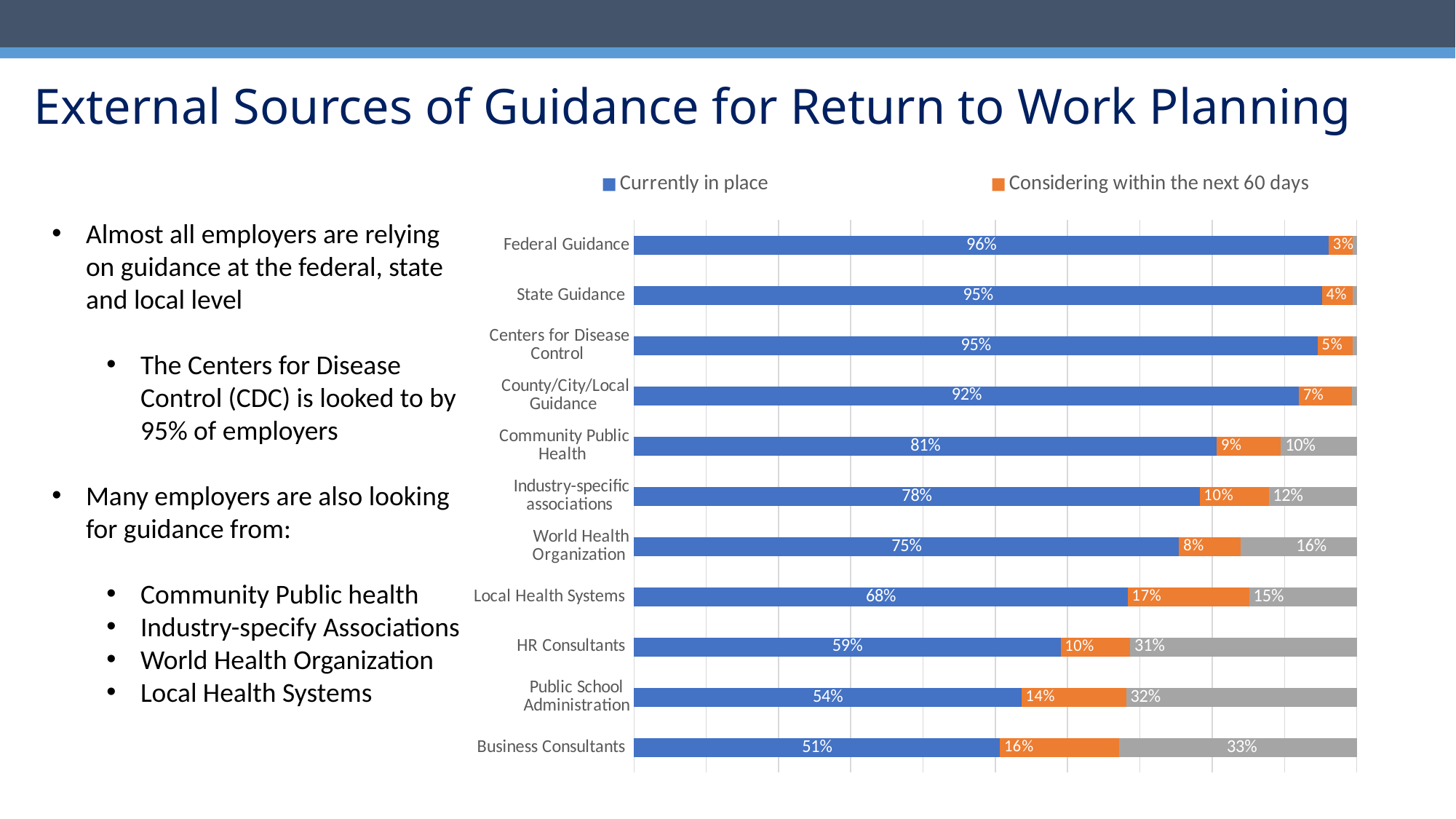
What is the difference between the 'Currently in place' values for Federal Guidance and Business Consultants? 45% What colour represents the 'Considering within the next 60 days' series? Orange What is the 'Currently in place' value for Business Consultants? 51% What percentage of employers currently have Federal Guidance in place? 96% What kind of chart is shown on the slide? Stacked bar chart What is the 'Considering within the next 60 days' value for Local Health Systems? 17% Which has a larger 'Currently in place' value, World Health Organization or HR Consultants? World Health Organization Which category has the highest 'Currently in place' value? Federal Guidance How many series does the legend list? 2 Which category has the highest 'Considering within the next 60 days' value? Local Health Systems How many categories are shown on the chart? 11 Which category has the lowest 'Currently in place' value? Business Consultants